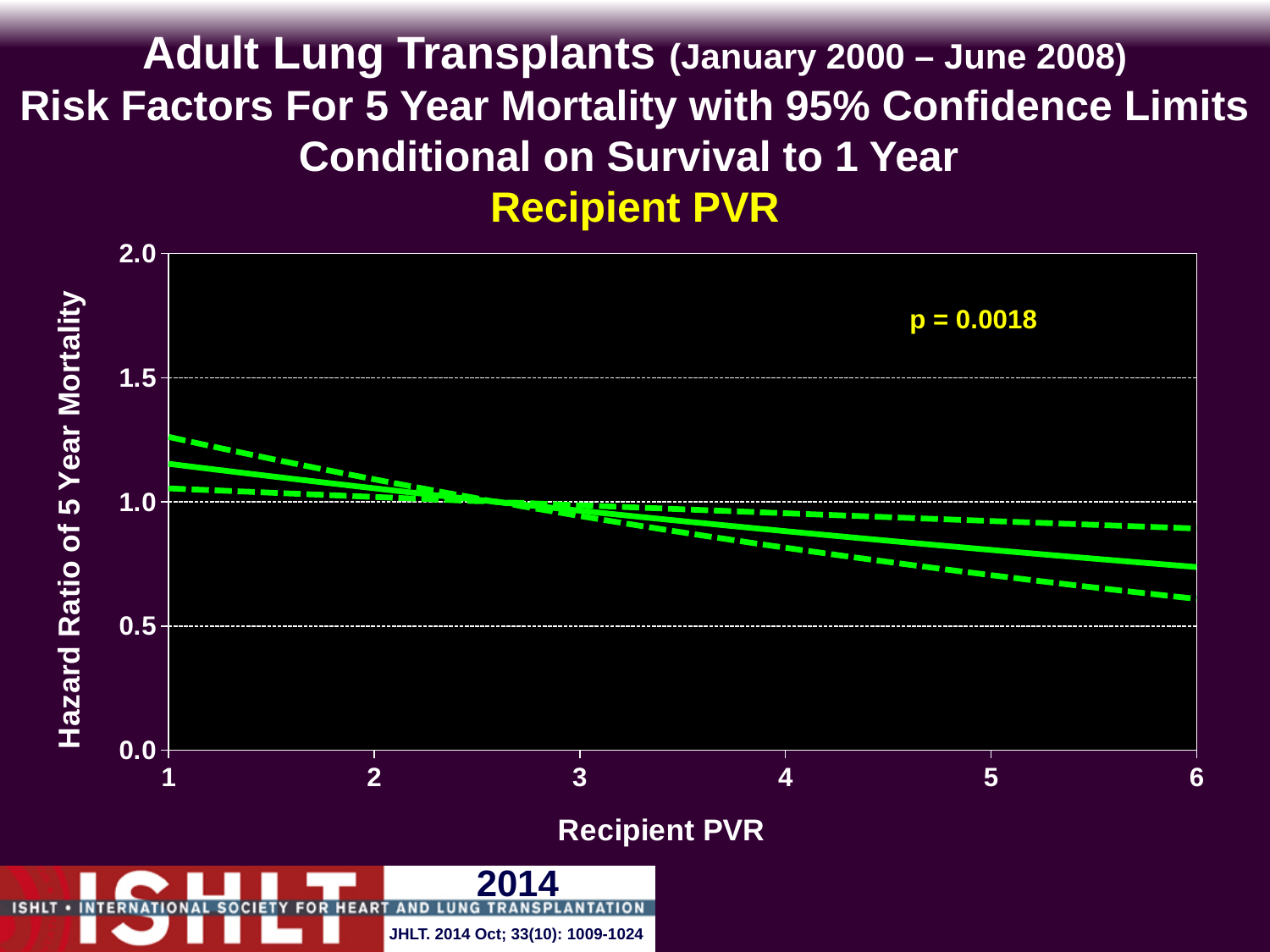
What kind of chart is shown on the slide? line chart Is the upper 95% confidence limit (upper dashed line) at a Recipient PVR of 1 greater or less than 1.0? greater Is the lower 95% confidence limit (lower dashed line) at a Recipient PVR of 6 greater or less than 0.5? greater What p-value is shown on the chart? p = 0.0018 Is the hazard ratio (solid line) at a Recipient PVR of 6 greater or less than 1.0? less What is the label of the y axis of the chart? Hazard Ratio of 5 Year Mortality Does the hazard ratio of 5 year mortality rise or fall as Recipient PVR increases from 1 to 6? fall Is the hazard ratio (solid line) larger at a Recipient PVR of 1 or at a Recipient PVR of 6? Recipient PVR of 1 How many lines are plotted on the chart? 3